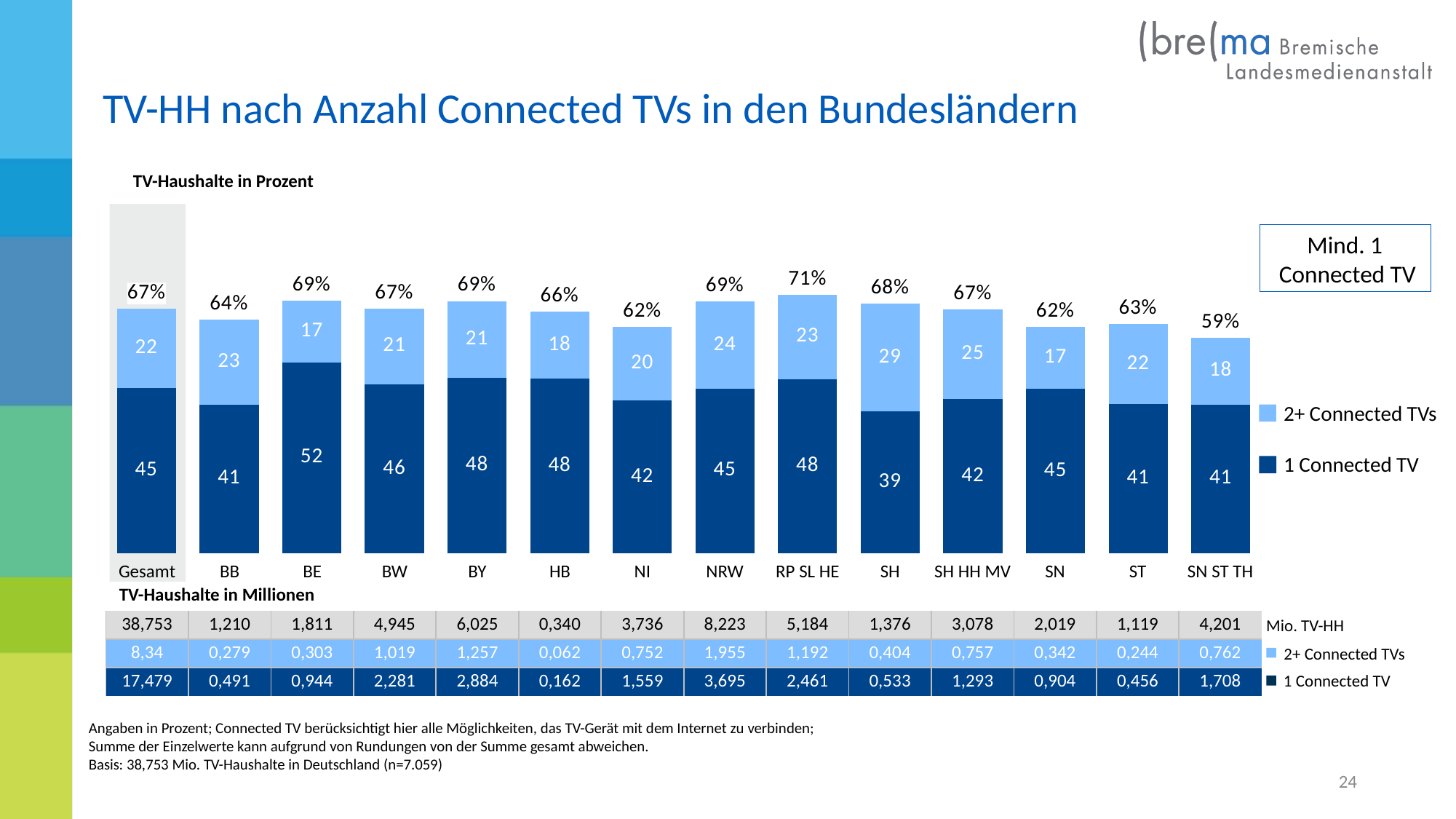
Which category has the highest value for 2+ Connected TVs? SH How many series does the chart legend list? 2 What is the value for 2+ Connected TVs in SH? 29 What is the total share (Mind. 1 Connected TV) for Gesamt? 67% Which Bundesland has the highest share of TV households with at least one Connected TV (Mind. 1 Connected TV)? RP SL HE What is the difference between the 1 Connected TV value for BE and for SH? 13 How many categories are shown on the x axis of the bar chart? 14 What is the value for 1 Connected TV in BE? 52 What kind of chart is shown on the slide? Stacked bar chart Which has a larger 2+ Connected TVs value, BB or BE? BB Which category has the lowest share of TV households with at least one Connected TV? SN ST TH In the table below the chart, how many Mio. TV-HH are listed for NRW? 8,223